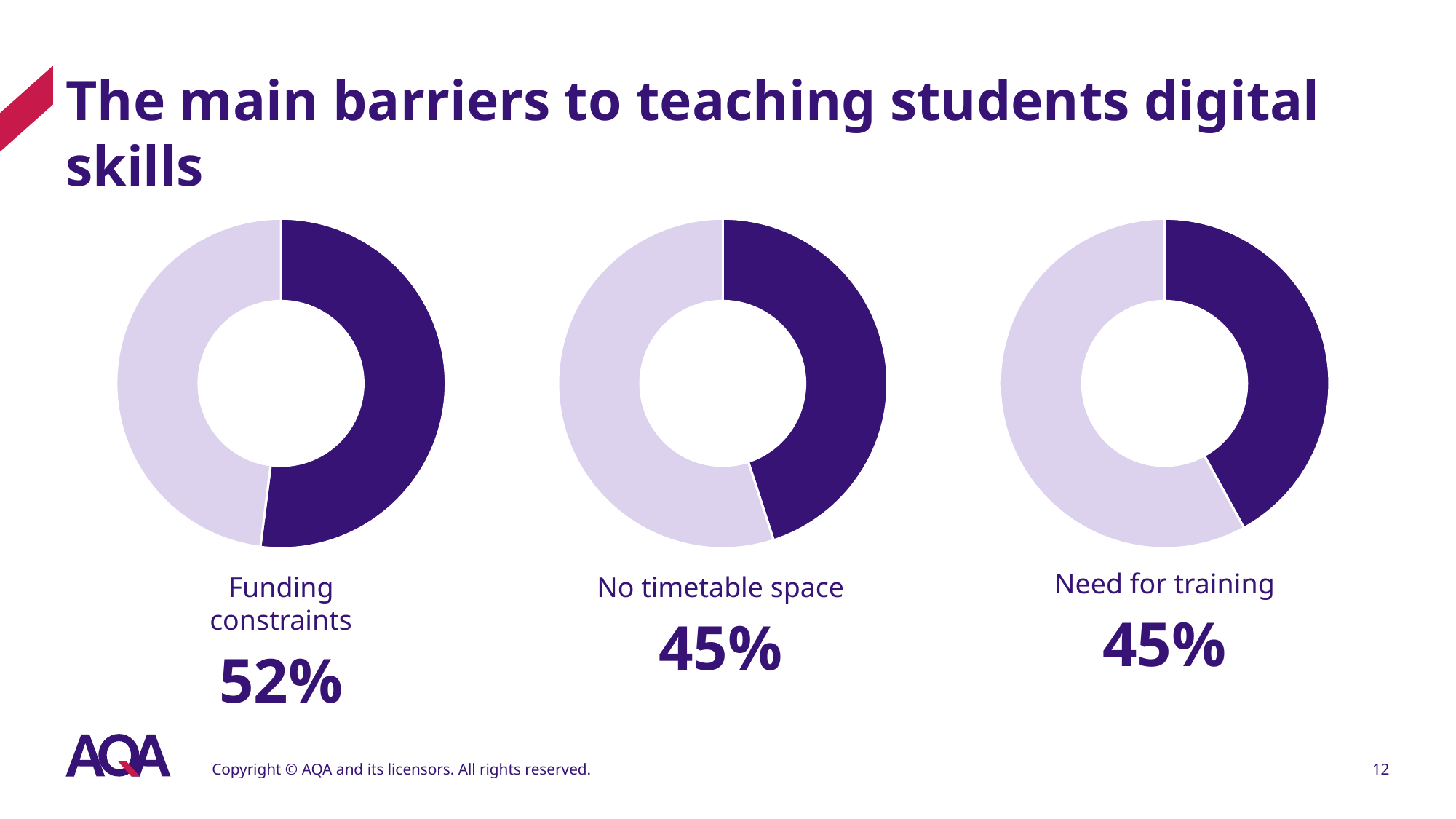
How many donut charts are shown on the slide? 3 What is the difference between the Funding constraints percentage and the Need for training percentage? 7 percentage points What kind of chart is used for Funding constraints? Donut chart What is the title of the slide? The main barriers to teaching students digital skills In the Funding constraints chart, what share of the ring does the dark purple segment represent? 52% What percentage is shown for the Need for training chart? 45% Which barrier is shown in the rightmost chart? Need for training Which is larger, the percentage for Funding constraints or the percentage for No timetable space? Funding constraints What percentage is shown for the Funding constraints chart? 52% What percentage is shown for the No timetable space chart? 45% Is the value for Funding constraints greater or less than 50%? greater Which barrier has the highest percentage across the three charts? Funding constraints